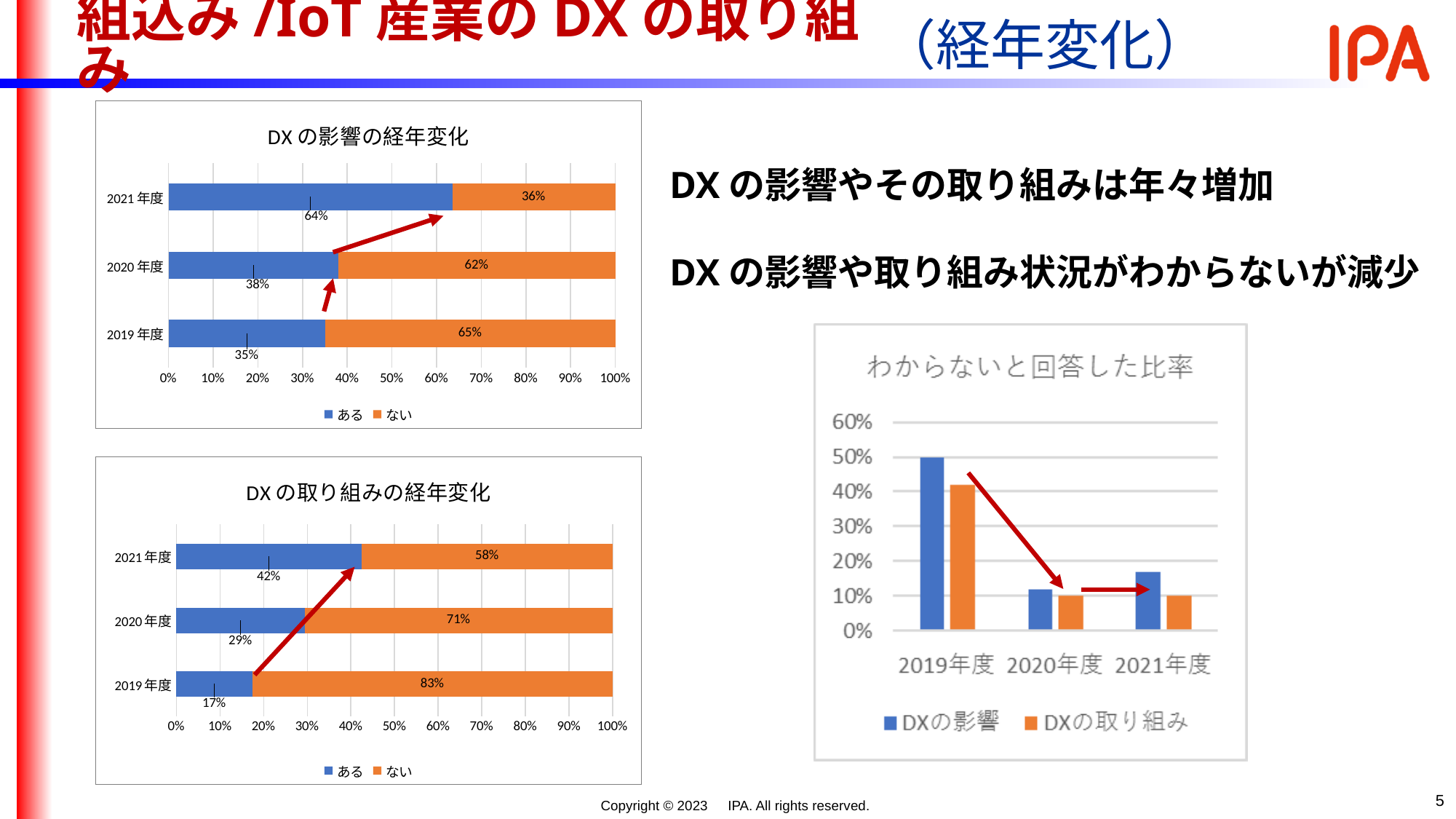
In the chart titled DXの影響の経年変化, what is the value of ない for 2019年度? 65% In the chart titled DXの取り組みの経年変化, what is the value of ない for 2020年度? 71% In the chart titled DXの影響の経年変化, which year has the highest value for ある? 2021年度 In the chart titled わからないと回答した比率, which year has the highest value for DXの取り組み? 2019年度 In the chart titled DXの影響の経年変化, what is the value of ある for 2021年度? 64% In the chart titled DXの取り組みの経年変化, how many series does the legend list? 2 What kind of chart is the chart titled わからないと回答した比率? bar chart In the chart titled わからないと回答した比率, is the value of DXの影響 for 2019年度 greater or less than 40%? greater In the chart titled DXの取り組みの経年変化, what is the value of ある for 2019年度? 17% In the chart titled DXの取り組みの経年変化, which year has the lowest value for ある? 2019年度 In the chart titled DXの取り組みの経年変化, does the ある value rise or fall from 2019年度 to 2021年度? rise In the chart titled DXの影響の経年変化, what is the difference between the ある values for 2021年度 and 2020年度? 26%